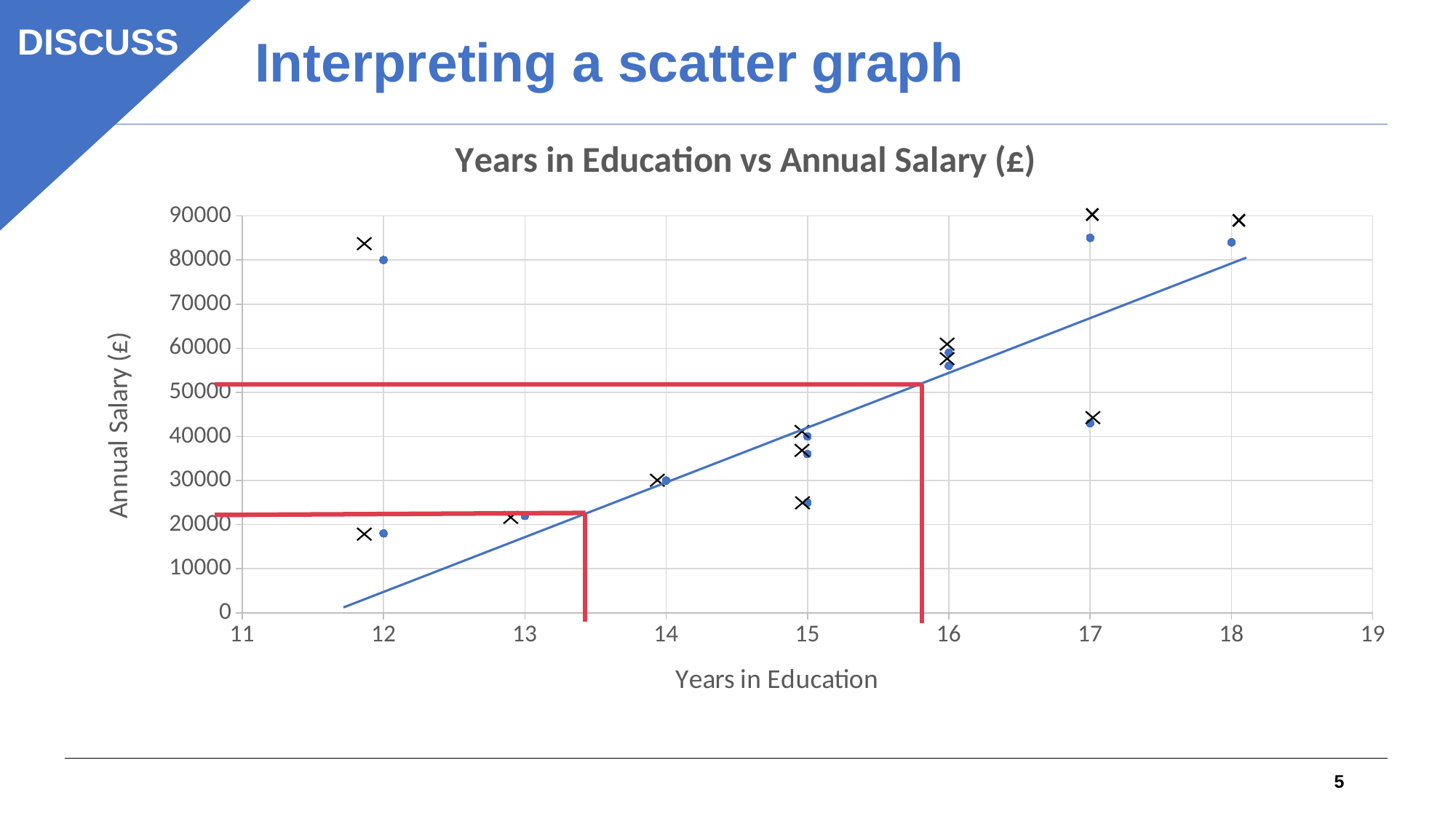
Is the annual salary for the highest point at 12 years in education greater or less than 70000? greater Is the annual salary for the point at 18 years in education greater or less than 80000? greater What kind of chart is shown on the slide? Scatter graph Is the annual salary for the lower point at 17 years in education greater or less than 50000? less At how many years in education is the lowest annual salary on the chart plotted? 12 How many data points are plotted on the scatter graph? 12 What is the label on the horizontal axis of the chart? Years in Education Does annual salary generally rise or fall as years in education increase along the x axis? Rise What is the title of the chart? Years in Education vs Annual Salary (£)